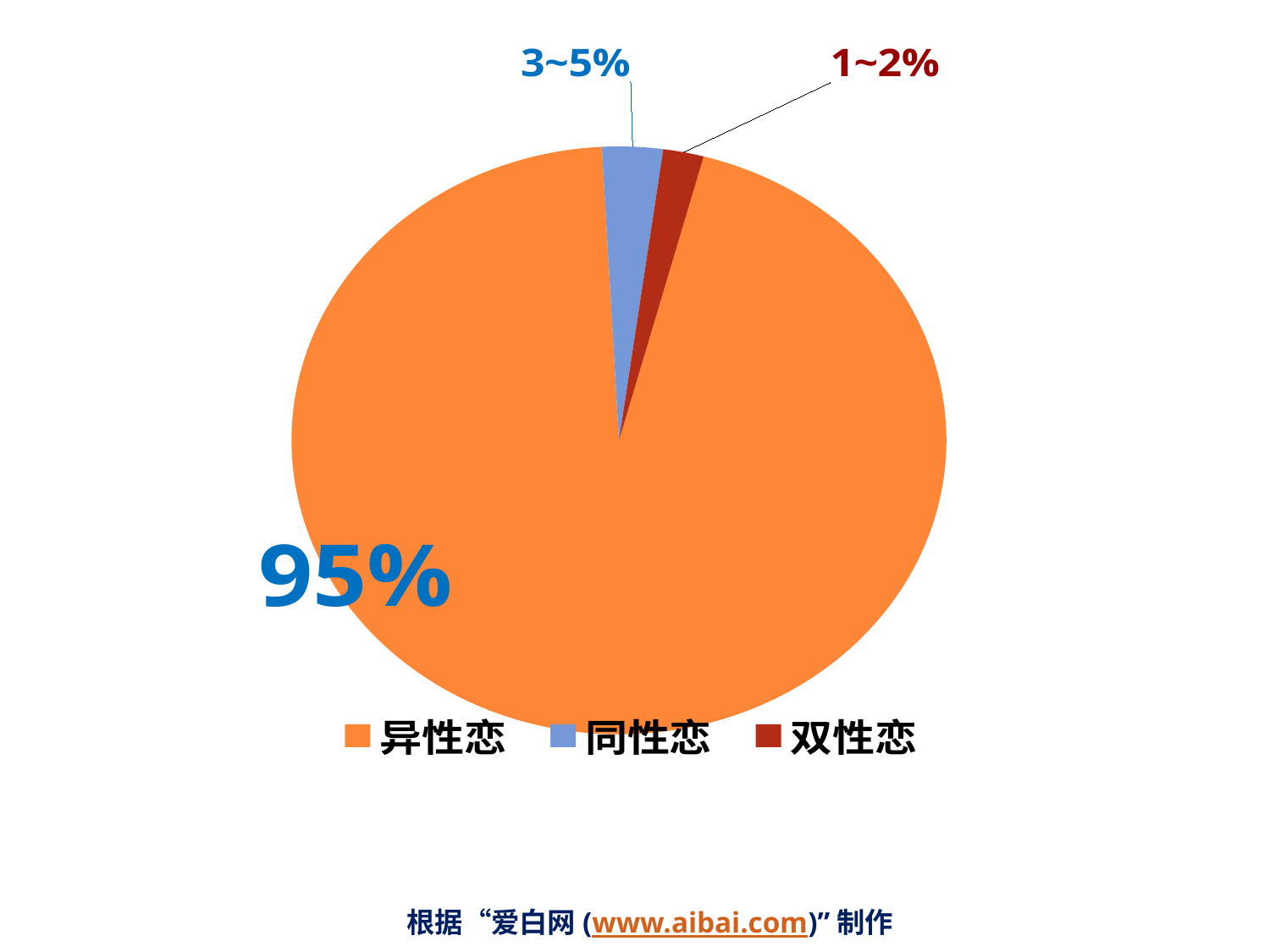
What is the value shown for 同性恋? 3~5% What is the value shown for 双性恋? 1~2% Which category has the smallest slice of the pie? 双性恋 Which category is shown in blue in the legend? 同性恋 Which category has the largest slice of the pie? 异性恋 How many entries does the legend list? 3 How many categories does the pie chart show? 3 Which slice is larger, 同性恋 or 双性恋? 同性恋 What kind of chart is shown on the slide? pie chart What is the value shown for 异性恋? 95% What colour is the slice for 异性恋? orange